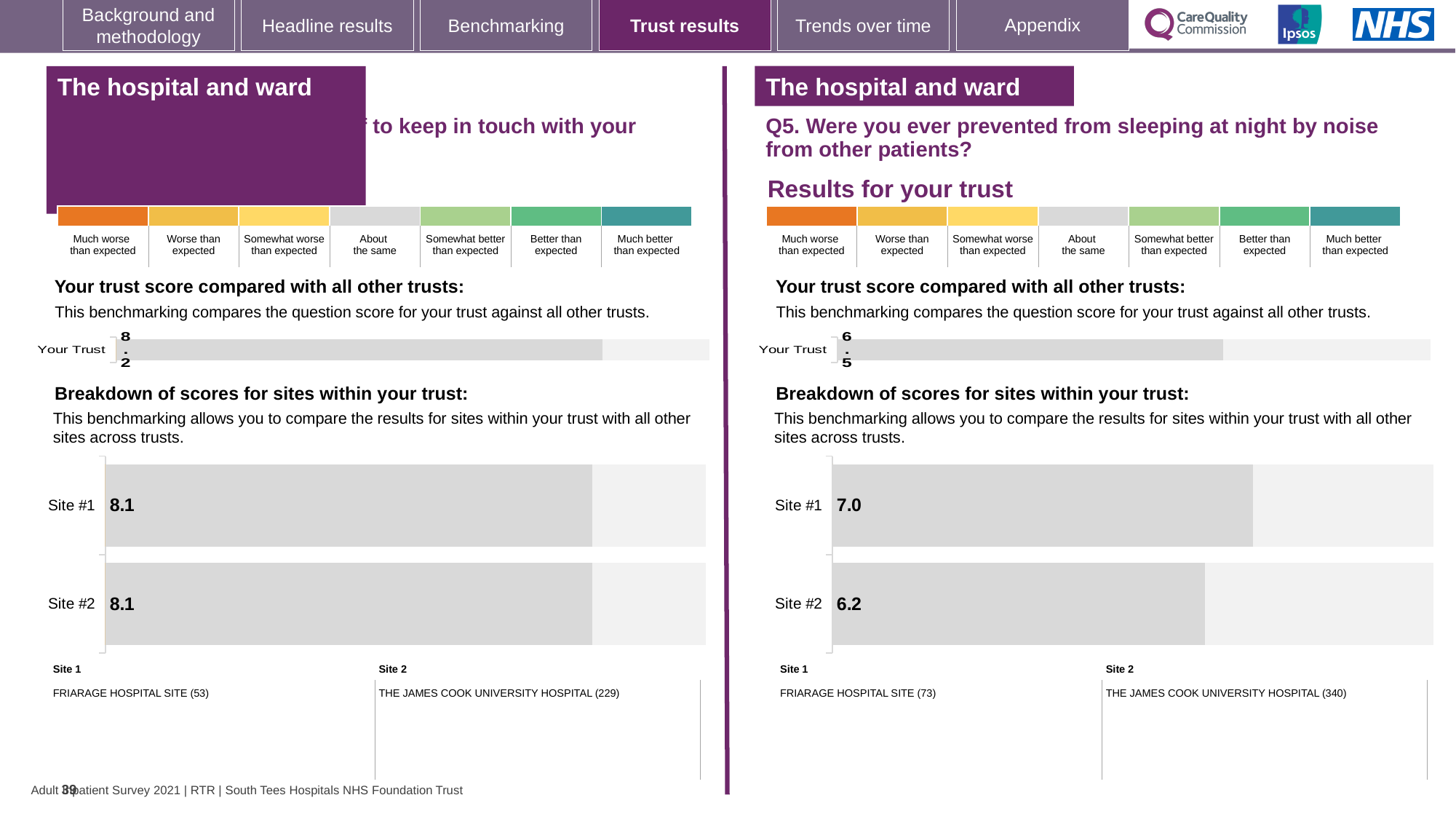
In the right-hand 'Breakdown of scores for sites within your trust' chart (Q5), what is the score for Site #1? 7.0 In the right-hand site breakdown chart (Q5), what is the difference between the Site #1 and Site #2 scores? 0.8 In the right-hand 'Breakdown of scores for sites within your trust' chart (Q5), what is the score for Site #2? 6.2 In the left-hand site breakdown chart, is the score for Site #2 higher than, lower than, or equal to the score for Site #1? equal In the right-hand site breakdown chart (Q5), which site has the higher score? Site #1 What type of chart is used for the 'Breakdown of scores for sites within your trust' on the right-hand side? bar chart How many sites are shown in the right-hand 'Breakdown of scores for sites within your trust' chart? 2 On the right-hand side (Q5, prevented from sleeping by noise from other patients), what is the trust score shown in the 'Your trust score compared with all other trusts' chart? 6.5 Which hospital is listed as Site 1 on the left-hand side of the slide? FRIARAGE HOSPITAL SITE (53) On the left-hand side of the slide, what is the trust score shown in the 'Your trust score compared with all other trusts' chart? 8.2 In the left-hand 'Breakdown of scores for sites within your trust' chart, what is the score for Site #1? 8.1 Which hospital is listed as Site 2 on the right-hand side of the slide (Q5)? THE JAMES COOK UNIVERSITY HOSPITAL (340)